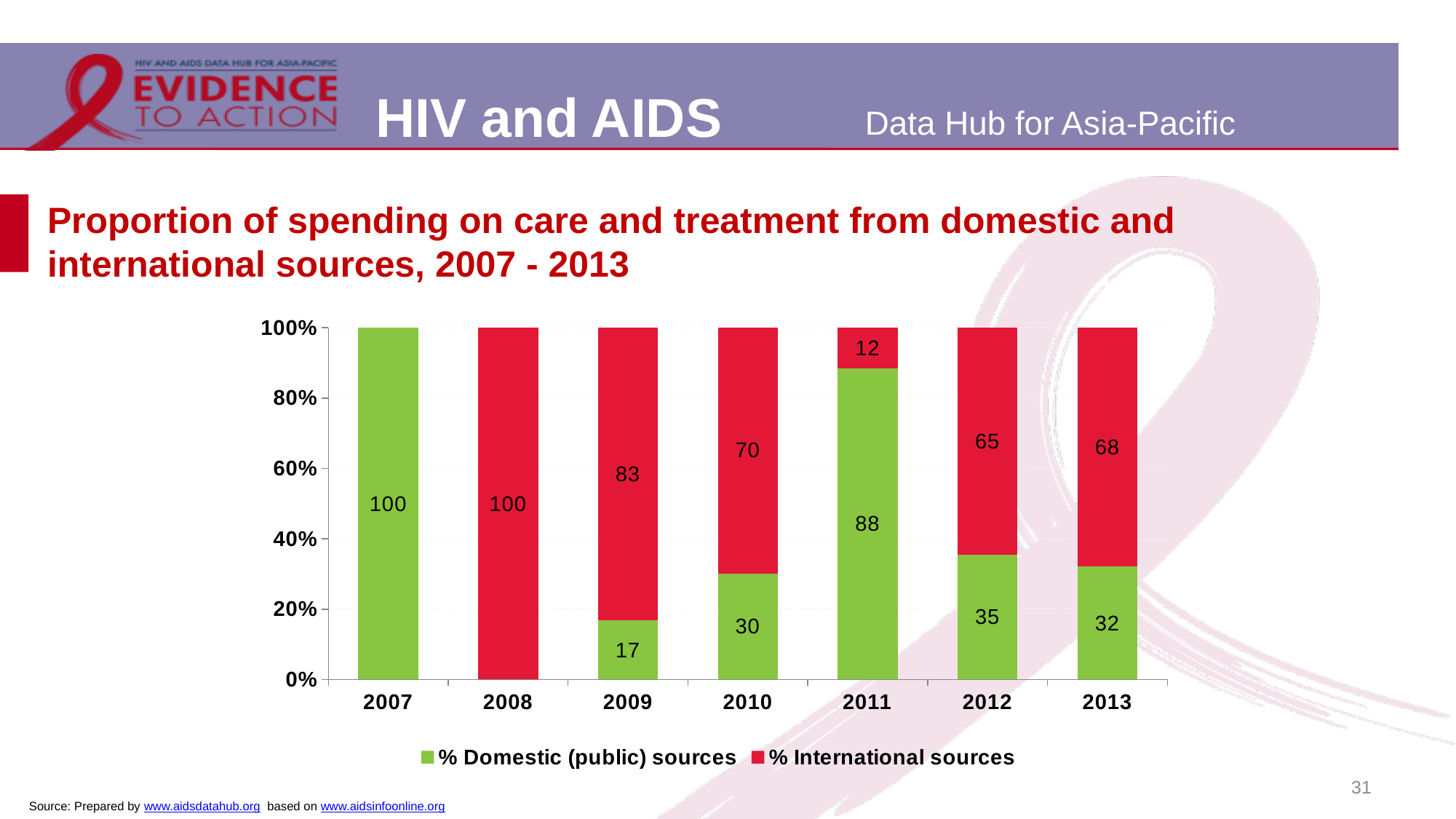
Which year has the highest value for % International sources? 2008 How many series does the legend list? 2 What is the value for % International sources in 2012? 65 Among the years 2009 to 2013, which year has the lowest value for % Domestic (public) sources? 2009 What is the difference between the % International sources values for 2013 and 2012? 3 What is the value for % Domestic (public) sources in 2011? 88 Is the value for % Domestic (public) sources larger in 2012 or in 2013? 2012 How many years are shown on the x axis? 7 Which colour represents % International sources in the chart? Red What is the value for % International sources in 2010? 70 What kind of chart is shown on the slide? Stacked bar chart What is the value for % Domestic (public) sources in 2009? 17